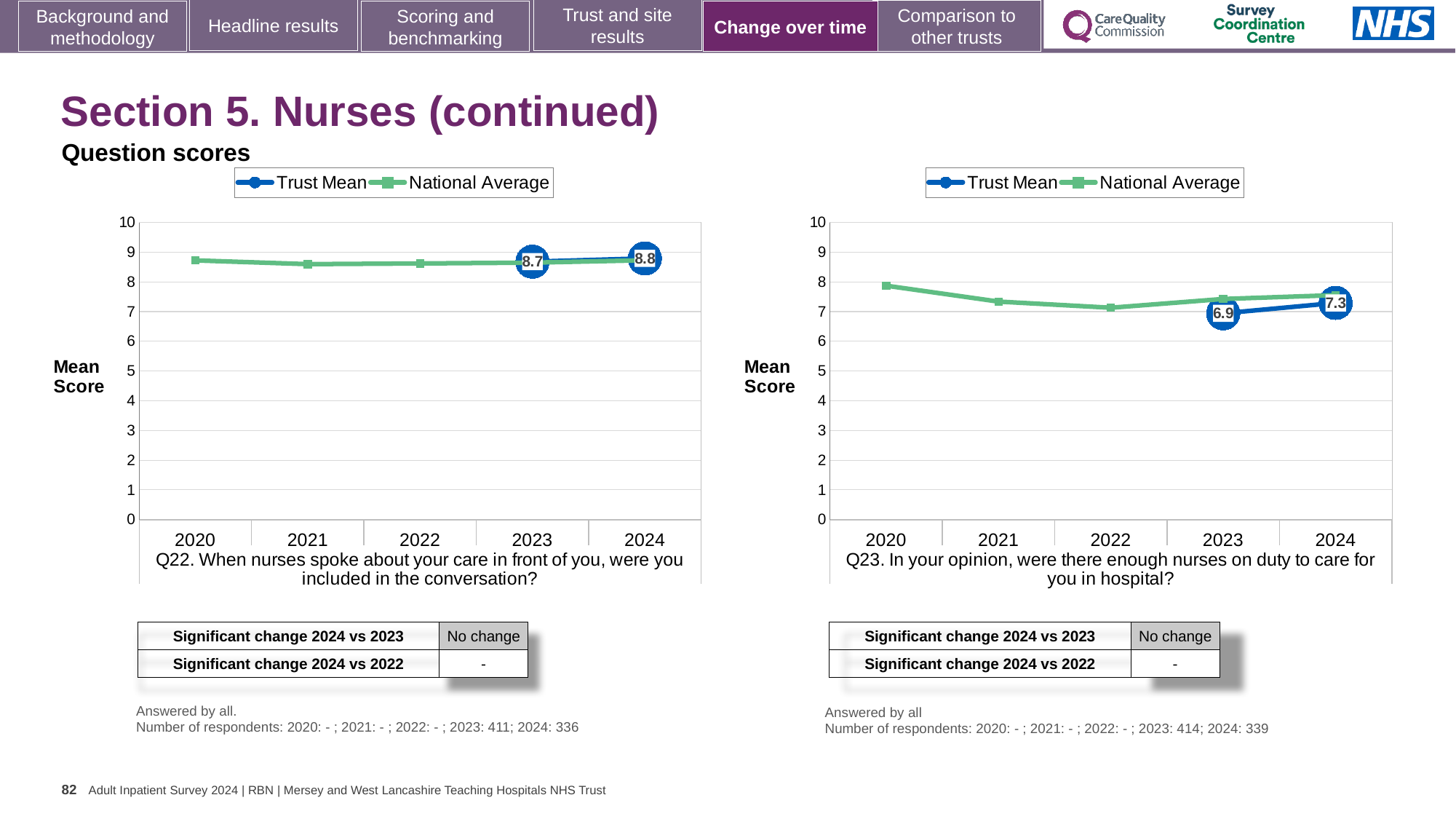
On the Q23 chart (right), what is the difference between the Trust Mean values for 2024 and 2023? 0.4 On the Q22 chart (left), is the National Average value for 2020 greater or less than 8? greater On the Q23 chart (right), is the National Average value for 2022 greater or less than 8? less On the Q23 chart (right), what is the Trust Mean value for 2024? 7.3 On the Q22 chart (left), what is the Trust Mean value for 2023? 8.7 What kind of chart is the Q23 chart (right)? line chart How many series does the legend of the Q22 chart (left) list? 2 On the Q23 chart (right), what is the Trust Mean value for 2023? 6.9 On the Q23 chart (right), does the Trust Mean rise or fall from 2023 to 2024? rise On the Q23 chart (right), is the Trust Mean for 2024 larger or smaller than the Trust Mean for 2023? larger On the Q22 chart (left), what is the difference between the Trust Mean values for 2024 and 2023? 0.1 On the Q22 chart (left), what is the Trust Mean value for 2024? 8.8